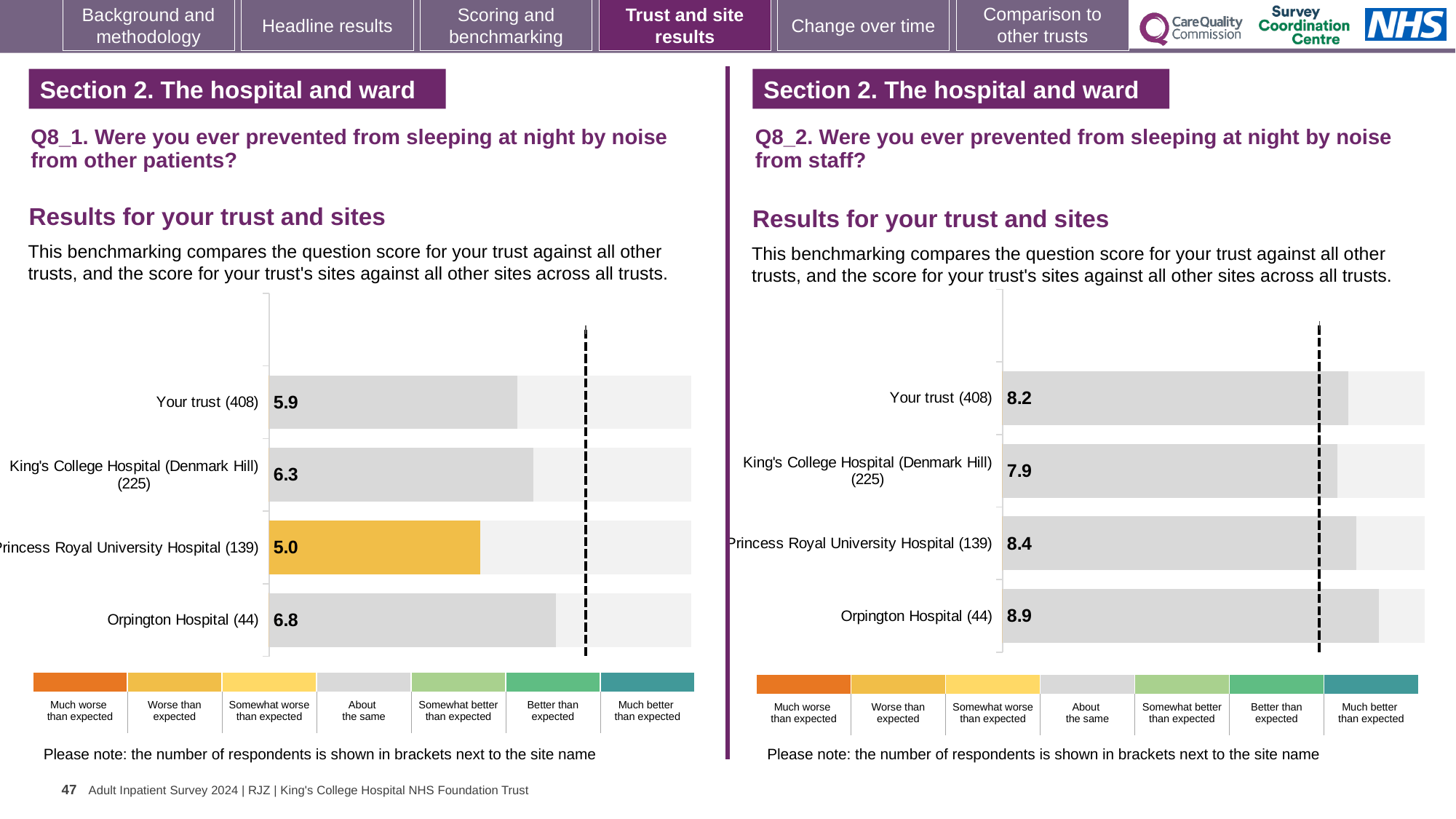
On the Q8_1 chart (left), how many bars are plotted? 4 On the Q8_2 chart (right), what is the score for Your trust (408)? 8.2 On the Q8_1 chart (left), what is the score for Your trust (408)? 5.9 On the Q8_2 chart (right), which site has the highest score? Orpington Hospital (44) On the Q8_2 chart (right), what is the score for King's College Hospital (Denmark Hill) (225)? 7.9 On the Q8_1 chart (left), what is the score for Princess Royal University Hospital (139)? 5.0 On the Q8_1 chart (left), which site has the highest score? Orpington Hospital (44) On the Q8_1 chart (left), which site has the lowest score? Princess Royal University Hospital (139) What type of chart is used on the Q8_2 chart (right)? Bar chart On the Q8_1 chart (left), what is the difference between the scores for Orpington Hospital (44) and King's College Hospital (Denmark Hill) (225)? 0.5 On the Q8_1 chart (left), which bar is coloured differently from the others? Princess Royal University Hospital (139) On the Q8_2 chart (right), which is larger: the score for Princess Royal University Hospital (139) or King's College Hospital (Denmark Hill) (225)? Princess Royal University Hospital (139)